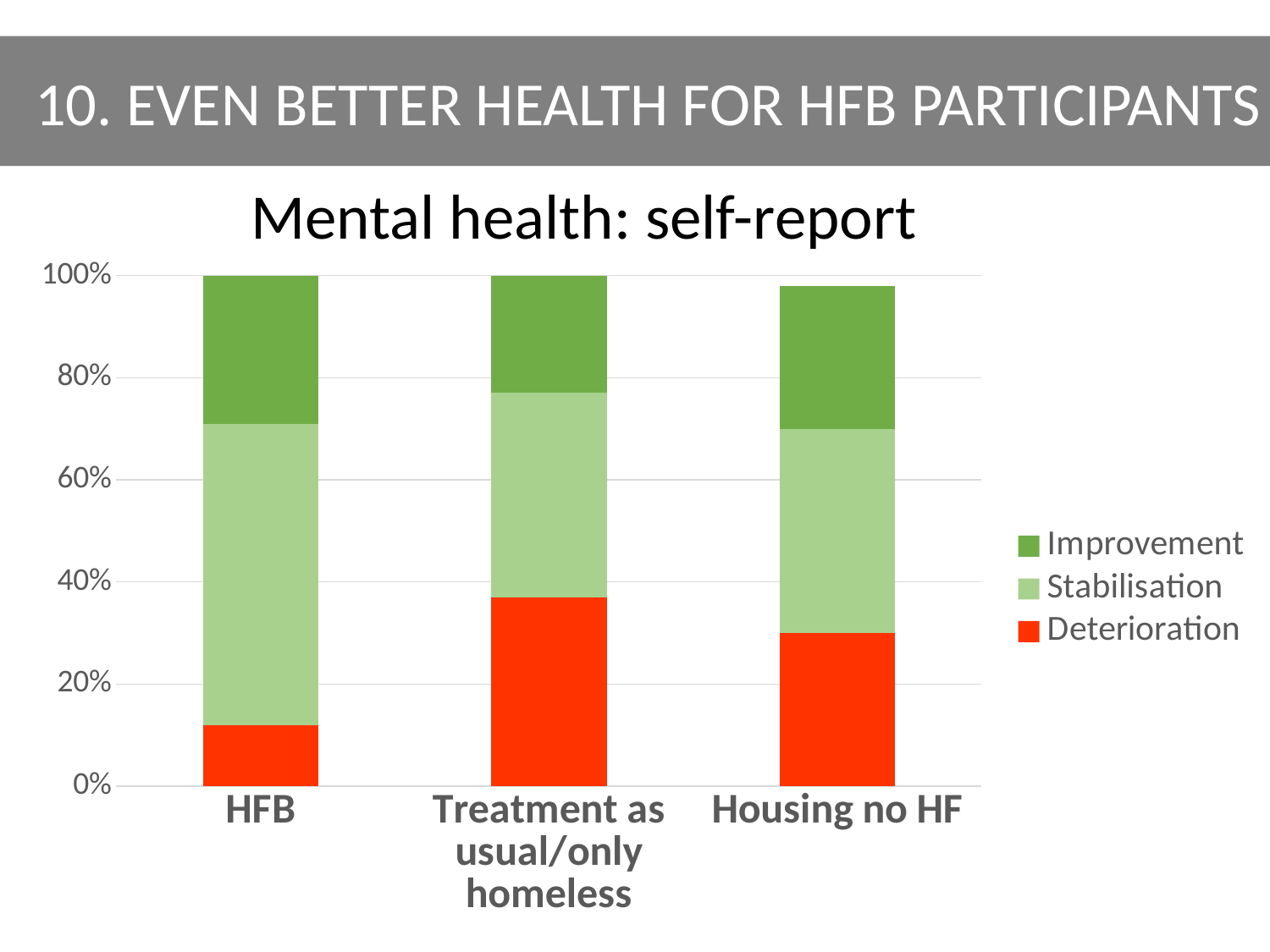
How many series does the chart's legend list? 3 Is the Deterioration segment larger for HFB or for Housing no HF? Housing no HF Which category has the smallest Deterioration segment? HFB Is the Deterioration value for Housing no HF greater or less than 40%? less How many categories are shown on the x axis of the chart? 3 Is the Deterioration value for HFB greater or less than 20%? less What is the title of the chart? Mental health: self-report Which colour represents Deterioration in the chart? Red Is the Deterioration value for Treatment as usual/only homeless greater or less than 20%? greater Which category has the largest Deterioration segment? Treatment as usual/only homeless Which category has the largest Stabilisation segment? HFB What kind of chart is shown on the slide? Stacked bar chart